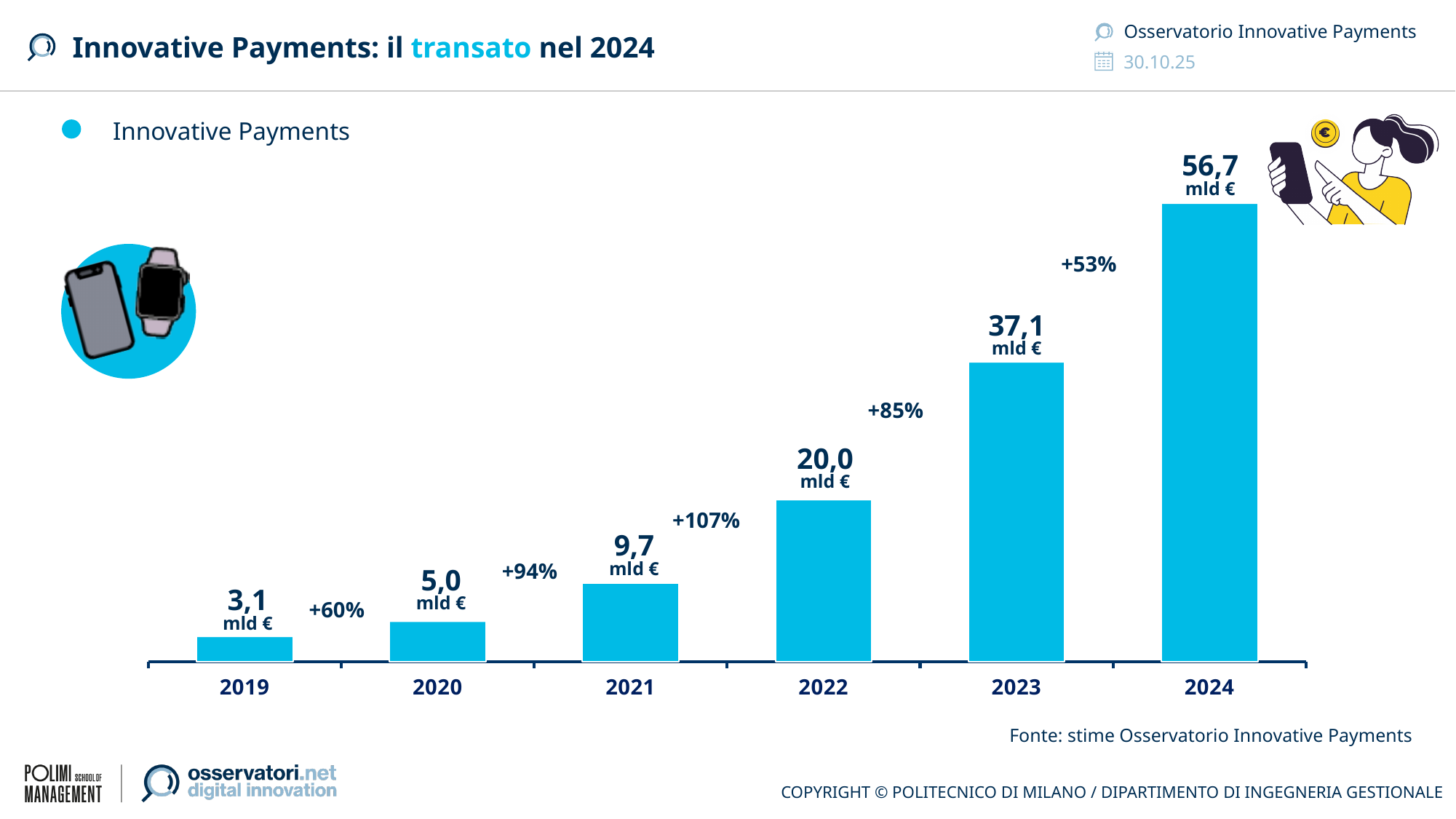
What is the percentage growth shown between 2023 and 2024? +53% What is the value for 2019? 3,1 mld € What is the value for 2024? 56,7 mld € Do the values rise or fall from 2019 to 2024? Rise What kind of chart is this? Bar chart Which year has the lowest value? 2019 How many years are shown on the x axis? 6 Which year has the highest value? 2024 What is the value for 2022? 20,0 mld € What is the difference between the 2024 and 2023 values? 19,6 mld € What is the percentage growth shown between 2021 and 2022? +107% Which is larger, the value for 2021 or the value for 2020? 2021